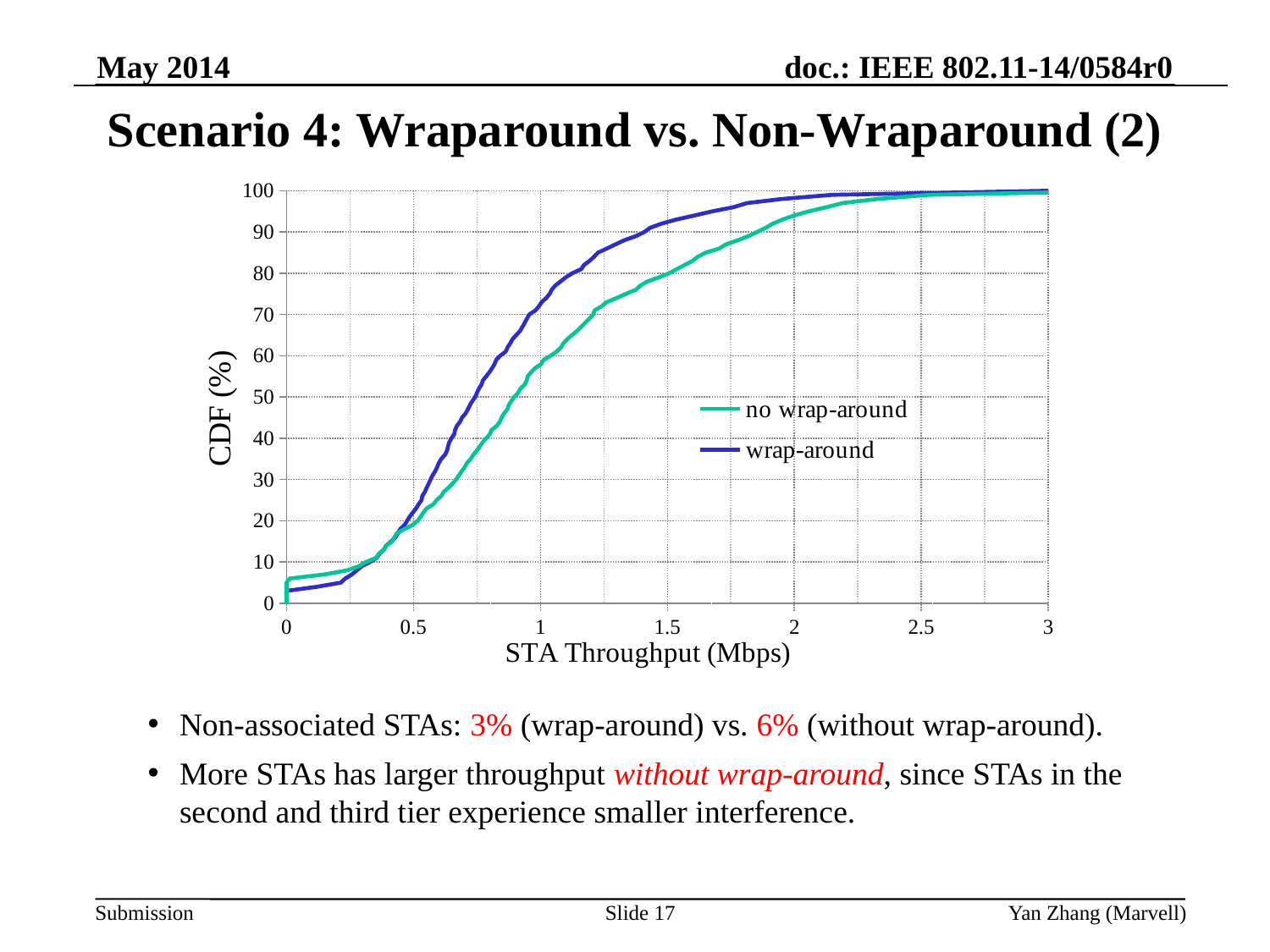
At a STA throughput of 1 Mbps, is the CDF value for wrap-around greater or less than 60? greater At a STA throughput of 1 Mbps, is the CDF value for no wrap-around greater or less than 50? greater At a STA throughput of 1.5 Mbps, which series has the higher CDF value, wrap-around or no wrap-around? wrap-around At a STA throughput of 2 Mbps, is the CDF value for wrap-around greater or less than 90? greater How many series does the legend list? 2 What is the highest value shown on the x axis of the chart? 3 At a STA throughput of 1.2 Mbps, which series has the higher CDF value, wrap-around or no wrap-around? wrap-around What kind of chart is shown on the slide? line chart Do the CDF curves rise or fall as STA throughput increases along the x axis? rise What are the two series named in the legend? no wrap-around, wrap-around What is the label of the x axis? STA Throughput (Mbps)